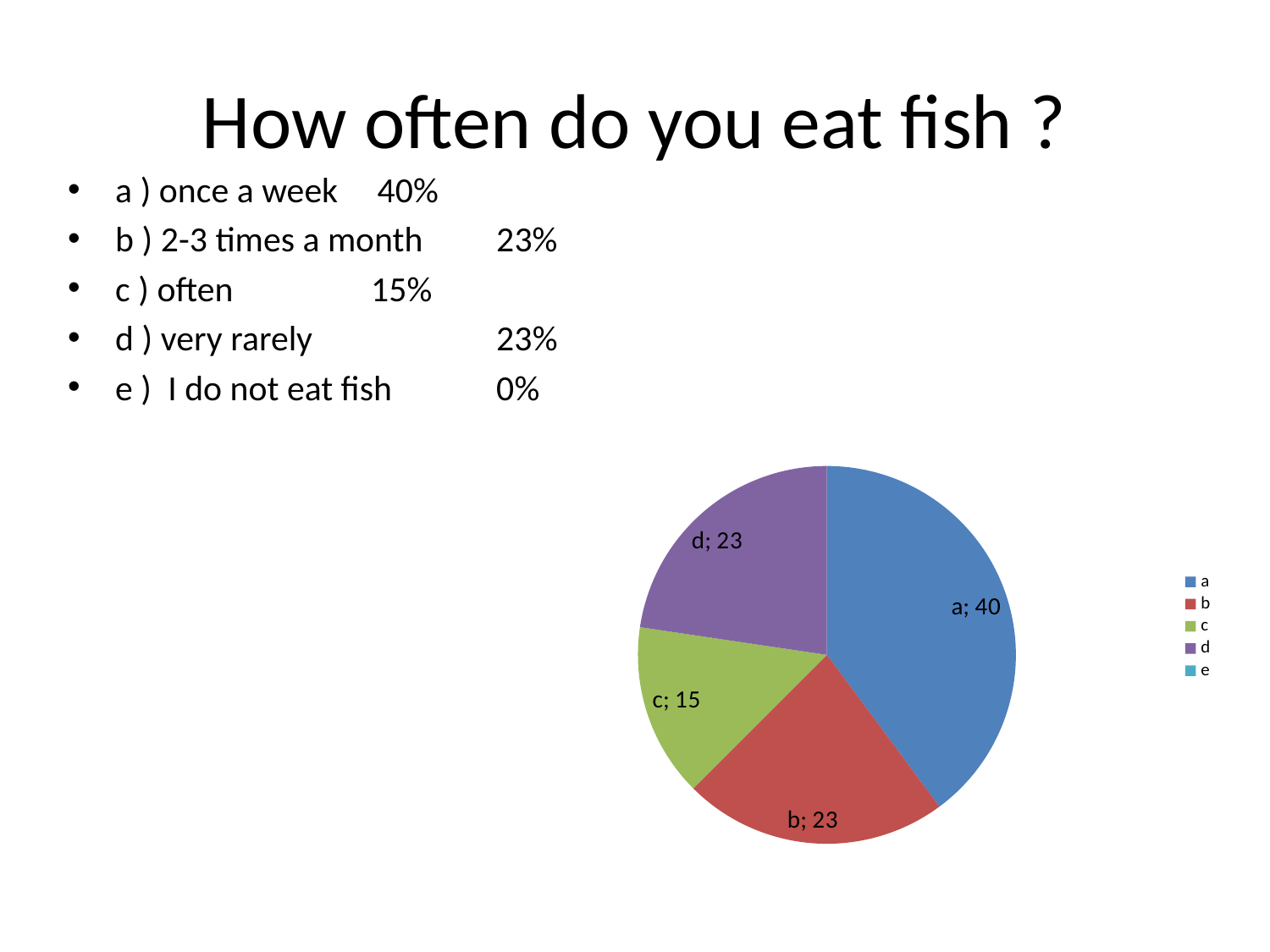
What is the difference between the labelled values for b and c in the pie chart? 8 What value is labelled on the slice for c in the pie chart? 15 What colour is the slice for a in the pie chart? blue How many entries does the legend of the pie chart list? 5 Which is larger in the pie chart, the value for a or the value for b? a What value is labelled on the slice for a in the pie chart? 40 Of the slices labelled on the pie chart, which is the smallest? c Which slice of the pie chart is the largest? a What value is labelled on the slice for d in the pie chart? 23 What type of chart is shown on the slide? pie chart What is the difference between the labelled values for a and c in the pie chart? 25 How many slices in the pie chart have a data label? 4